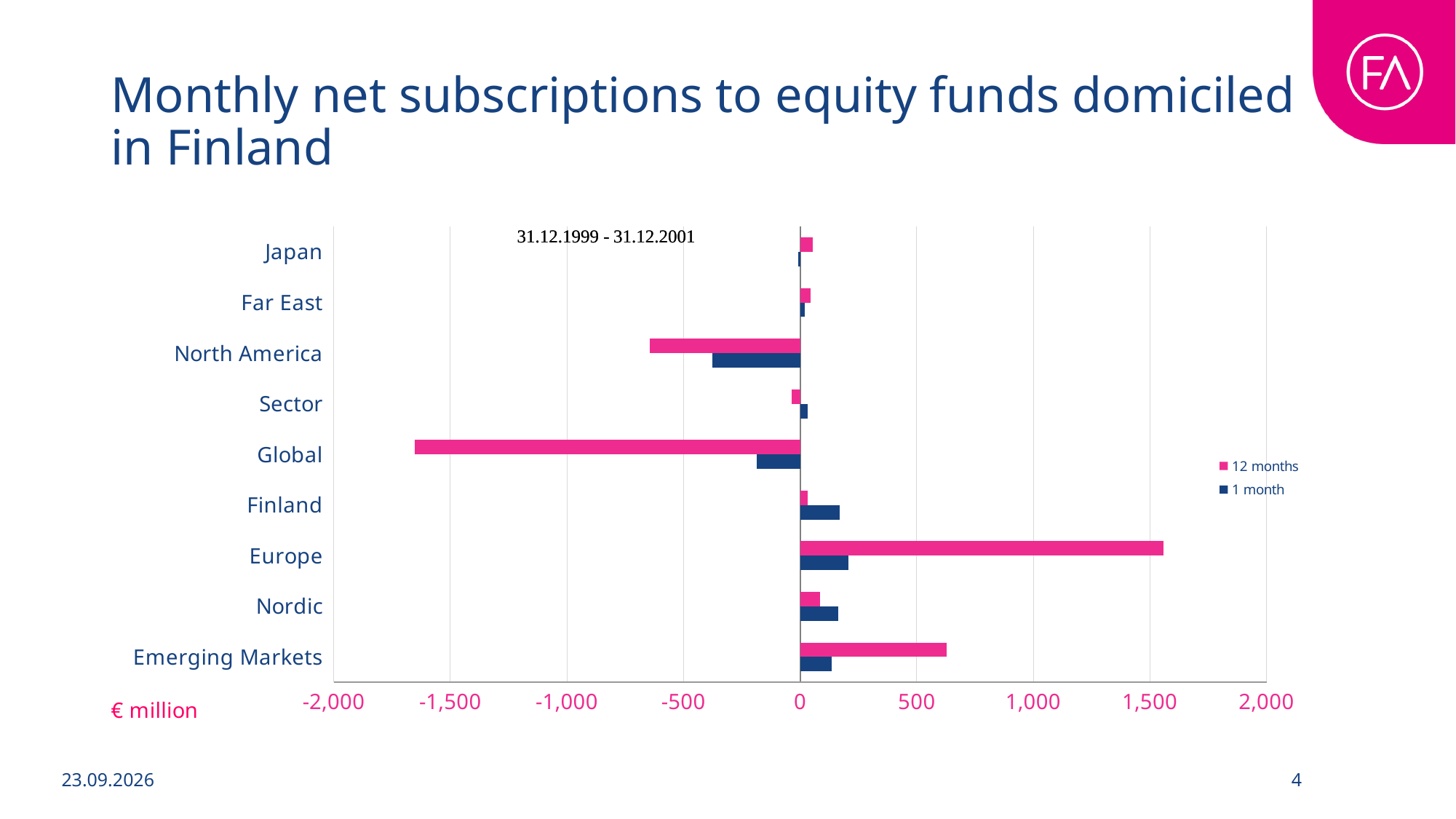
What unit is shown below the x axis of the chart? € million Is the 12 months value for Global greater or less than -1,500? less Which category has the lowest 12 months value? Global Is the 12 months value for North America greater or less than -500? less Which is larger, the 12 months value for Europe or for Emerging Markets? Europe Which category has the highest 12 months value? Europe What kind of chart is shown on the slide? bar chart Is the 12 months value for Emerging Markets greater or less than 500? greater How many categories are shown on the chart? 9 How many series does the legend list? 2 Which category has the lowest 1 month value? North America